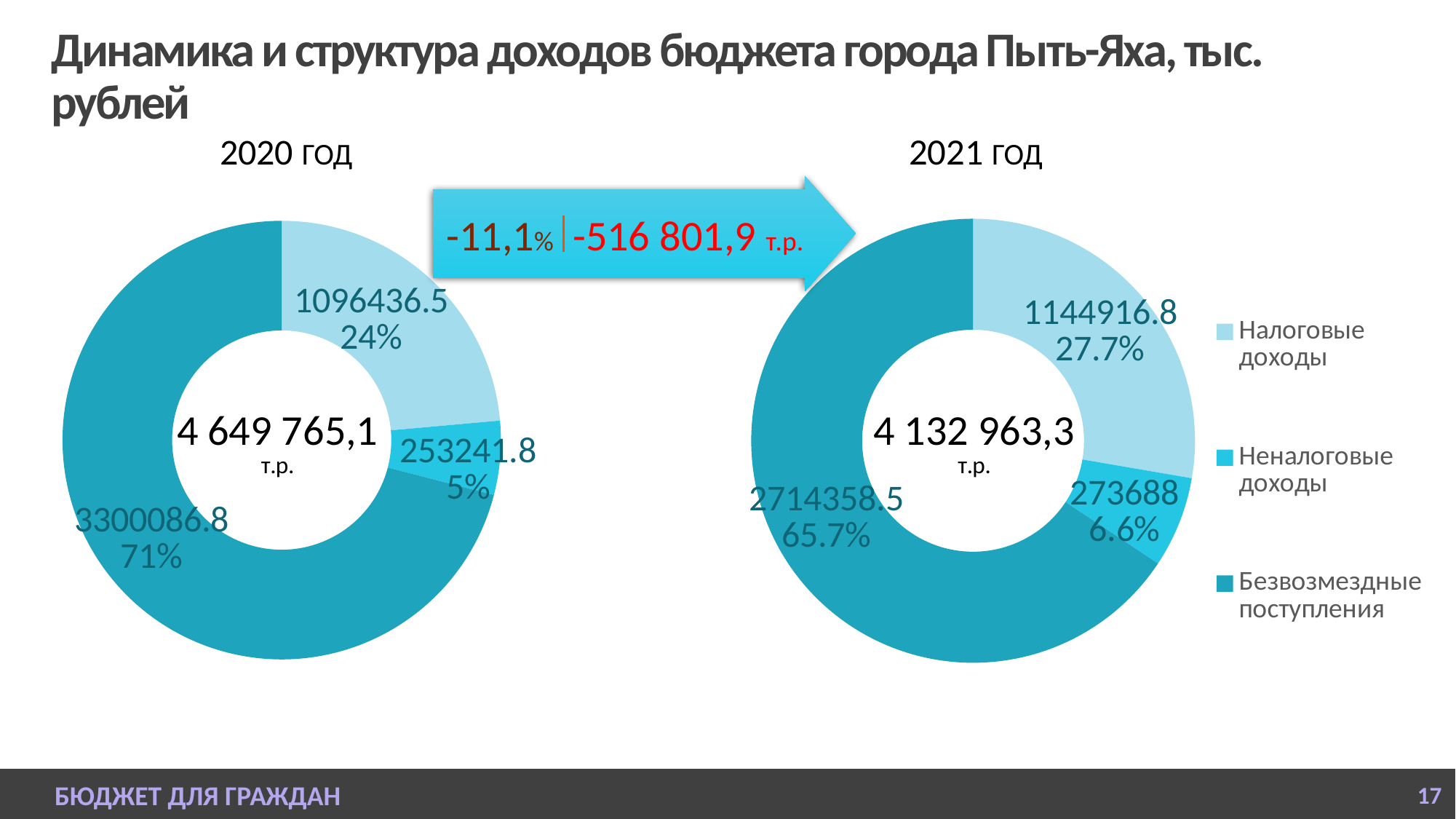
What total is shown in the centre of the 2021 год chart? 4 132 963,3 т.р. Which is larger: Налоговые доходы in the 2020 год chart or Налоговые доходы in the 2021 год chart? 2021 год In the 2020 год chart, what is the value for Налоговые доходы? 1096436.5 In the 2020 год chart, what share of the total is Безвозмездные поступления? 71% In the 2021 год chart, what is the value for Безвозмездные поступления? 2714358.5 What kind of chart is used for the 2020 год chart? Doughnut (pie) chart In the 2021 год chart, what is the value for Неналоговые доходы? 273688 In the 2020 год chart, which category has the smallest value? Неналоговые доходы In the 2021 год chart, which category has the largest value? Безвозмездные поступления What is the difference between Неналоговые доходы in the 2021 год chart and in the 2020 год chart? 20446.2 In the 2021 год chart, what share of the total is Налоговые доходы? 27.7% How many categories does the legend list? 3